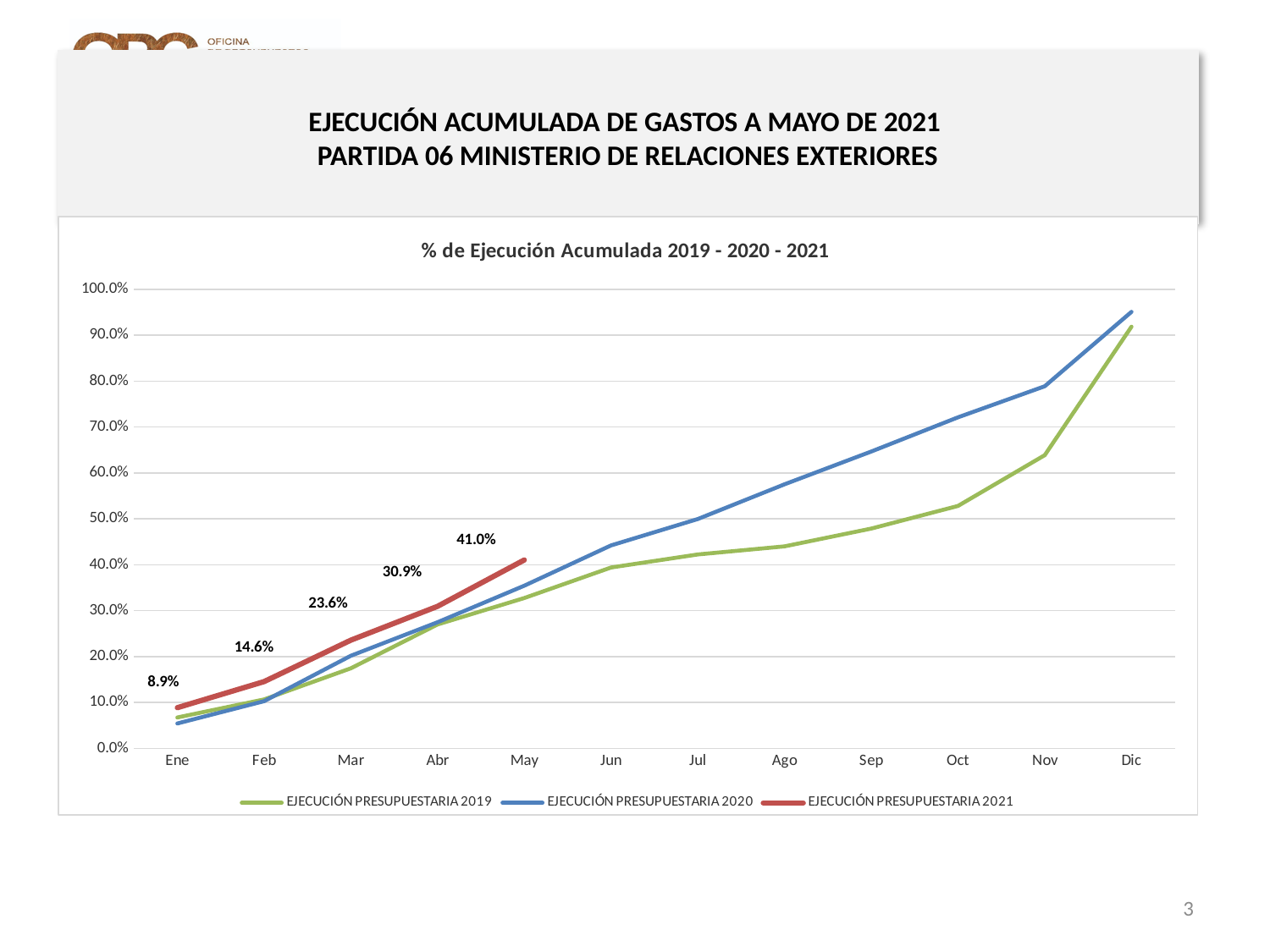
What kind of chart is shown on the slide? Line chart What is the value of EJECUCIÓN PRESUPUESTARIA 2021 in Ene? 8.9% Does the EJECUCIÓN PRESUPUESTARIA 2021 line rise or fall from Ene to May? Rise Is the value for EJECUCIÓN PRESUPUESTARIA 2020 in Dic greater or less than 90.0%? greater What is the value of EJECUCIÓN PRESUPUESTARIA 2021 in Abr? 30.9% By how much did EJECUCIÓN PRESUPUESTARIA 2021 increase from Abr to May? 10.1% What is the value of EJECUCIÓN PRESUPUESTARIA 2021 in Mar? 23.6% By how much did EJECUCIÓN PRESUPUESTARIA 2021 increase from Ene to Feb? 5.7% How many months are shown on the x axis? 12 How many series does the legend list? 3 Which series is higher in Dic, EJECUCIÓN PRESUPUESTARIA 2019 or EJECUCIÓN PRESUPUESTARIA 2020? EJECUCIÓN PRESUPUESTARIA 2020 What is the value of EJECUCIÓN PRESUPUESTARIA 2021 in May? 41.0%